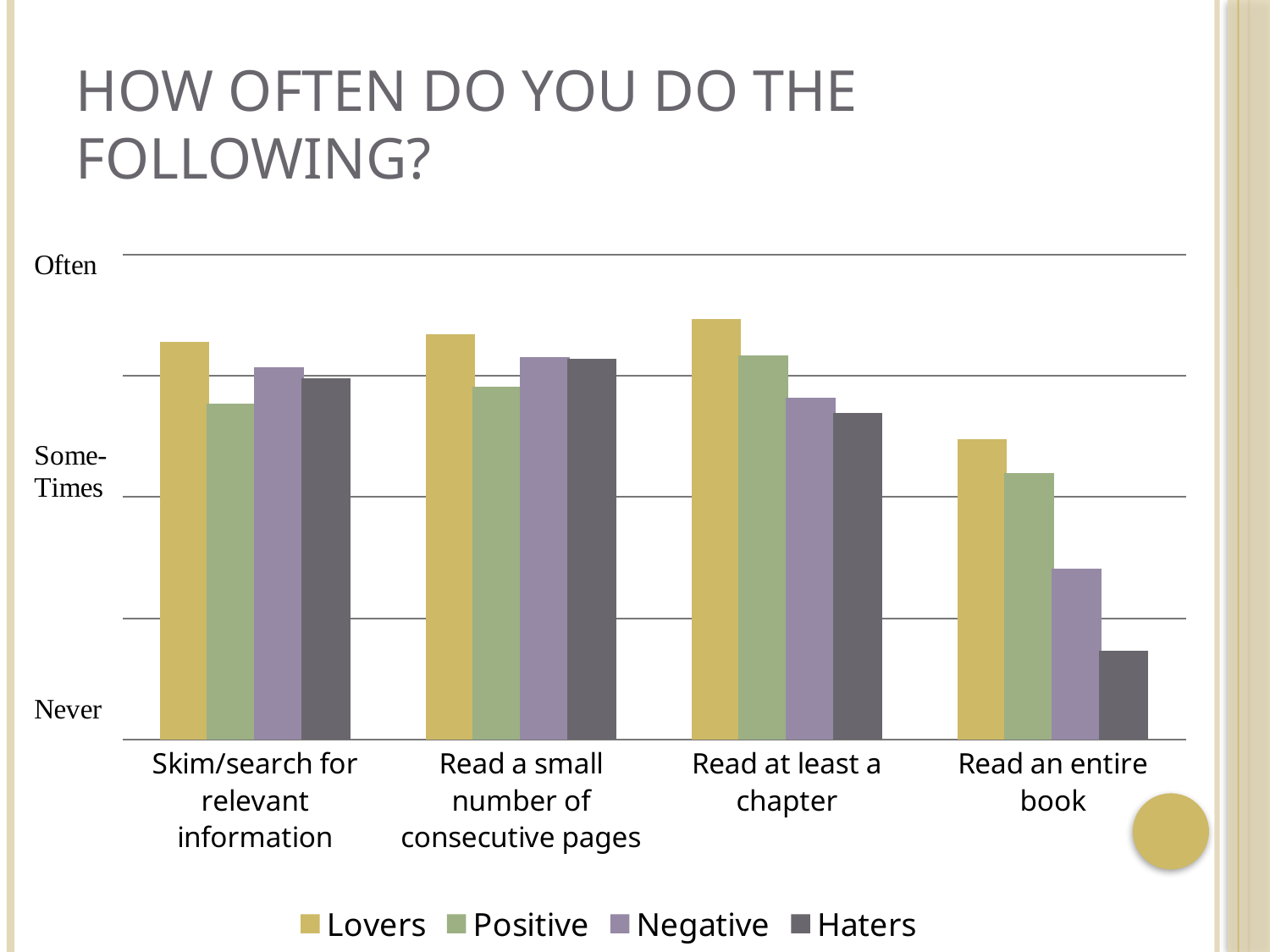
In the "Read an entire book" group, which is larger: the Positive bar or the Negative bar? Positive Which series has the highest bar in the "Read an entire book" group? Lovers How many reading activities (categories) are shown along the x axis? 4 For the Haters series, which activity has the lowest bar? Read an entire book What kind of chart is shown on the slide? Bar chart Which series has the lowest bar in the "Read an entire book" group? Haters Which series has the lowest bar in the "Read a small number of consecutive pages" group? Positive How many series does the legend list? 4 Which series has the highest bar in the "Read at least a chapter" group? Lovers In the "Skim/search for relevant information" group, which is larger: the Negative bar or the Positive bar? Negative For the Lovers series, which activity has the highest bar? Read at least a chapter What is the title of the chart on the slide? HOW OFTEN DO YOU DO THE FOLLOWING?